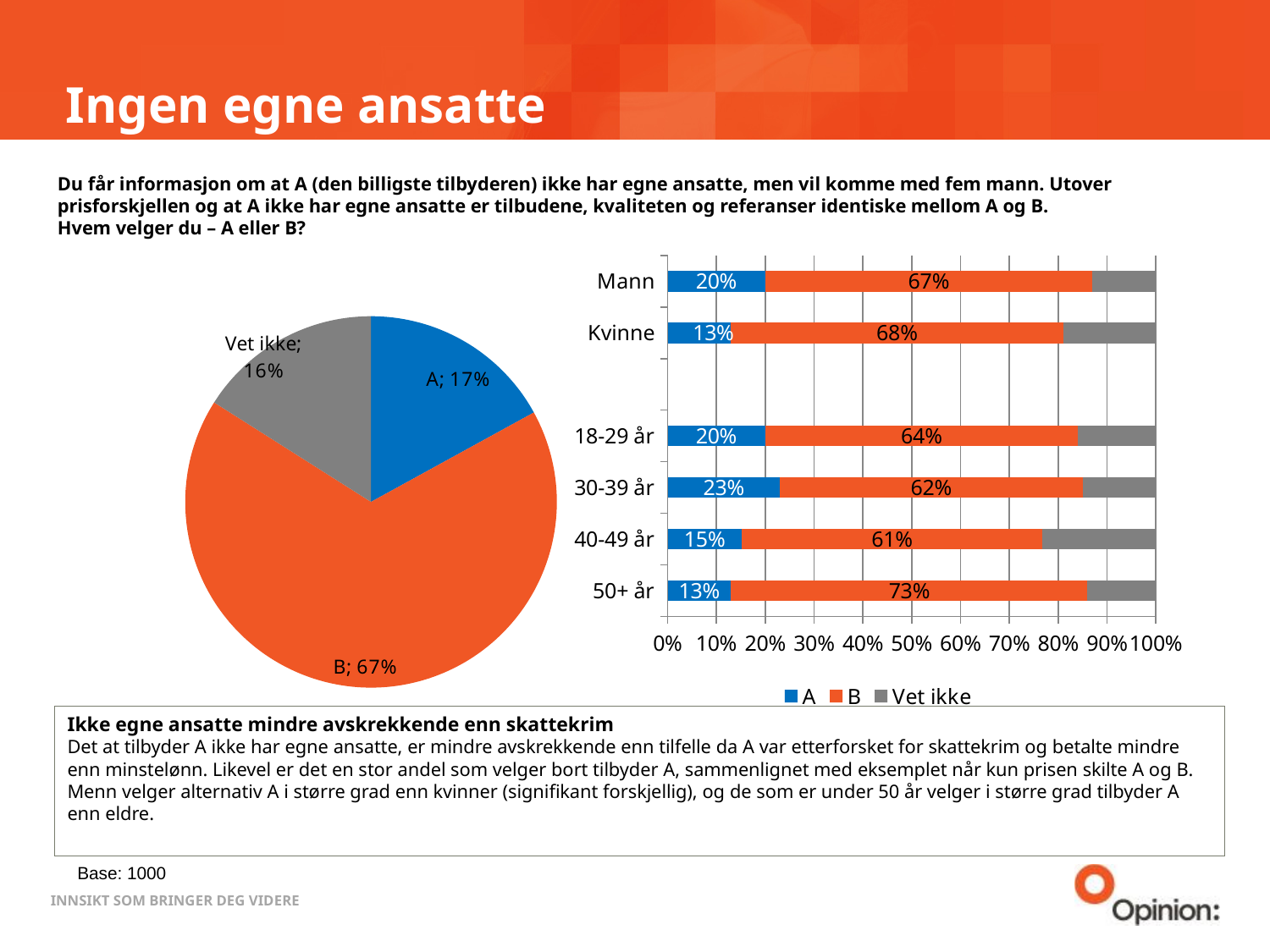
In the pie chart on the left, what share of respondents answered 'Vet ikke'? 16% In the bar chart on the right, what is the difference between the A values for Mann and Kvinne? 7 percentage points In the bar chart on the right, which category has the highest value for B? 50+ år In the pie chart on the left, which slice is the largest? B In the bar chart on the right, how many series does the legend list? 3 In the pie chart on the left, how many slices are there? 3 In the bar chart on the right, which category has the lowest value for B? 40-49 år In the bar chart on the right, what is the value of A for 30-39 år? 23% In the bar chart on the right, which is larger: the A value for 18-29 år or the A value for 40-49 år? 18-29 år What type of chart is shown on the right side of the slide? Bar chart In the pie chart on the left, what share of respondents chose B? 67% In the bar chart on the right, what is the value of B for 50+ år? 73%